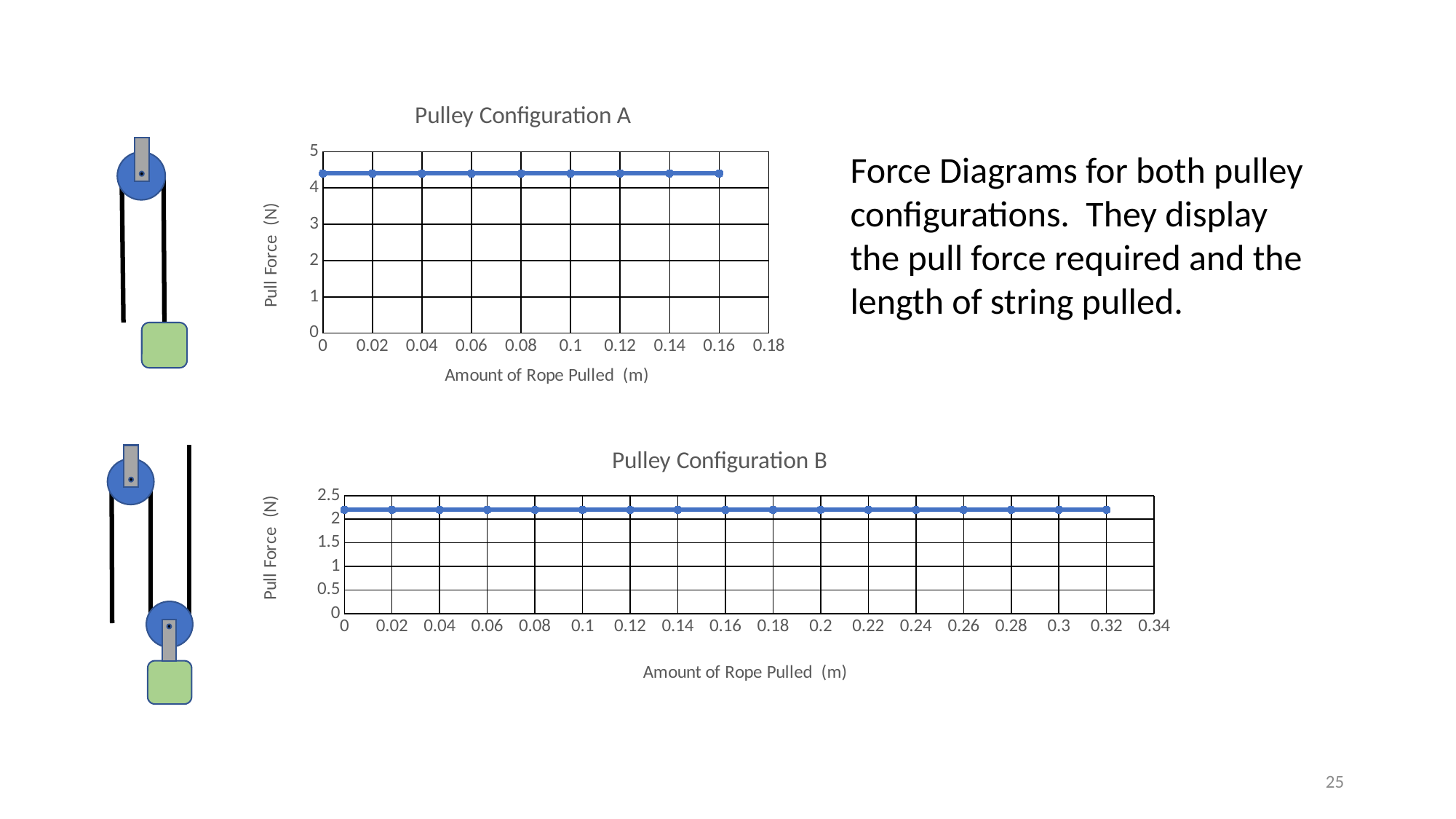
How many data points are plotted in "Pulley Configuration B"? 17 In "Pulley Configuration B", is the pull force at 0.1 m of rope pulled greater or less than 2 N? greater What kind of chart is "Pulley Configuration B"? line chart In "Pulley Configuration B", is the pull force at 0.32 m of rope pulled greater or less than 2.5 N? less In "Pulley Configuration A", is the pull force at 0.08 m of rope pulled greater or less than 4 N? greater In "Pulley Configuration A", does the pull force rise, fall, or stay constant as the amount of rope pulled increases? stays constant What kind of chart is "Pulley Configuration A"? line chart In "Pulley Configuration B", does the pull force rise, fall, or stay constant as the amount of rope pulled increases? stays constant Which chart shows the higher pull force, "Pulley Configuration A" or "Pulley Configuration B"? Pulley Configuration A How many data points are plotted in "Pulley Configuration A"? 9 What is the x-axis label of the "Pulley Configuration B" chart? Amount of Rope Pulled (m)